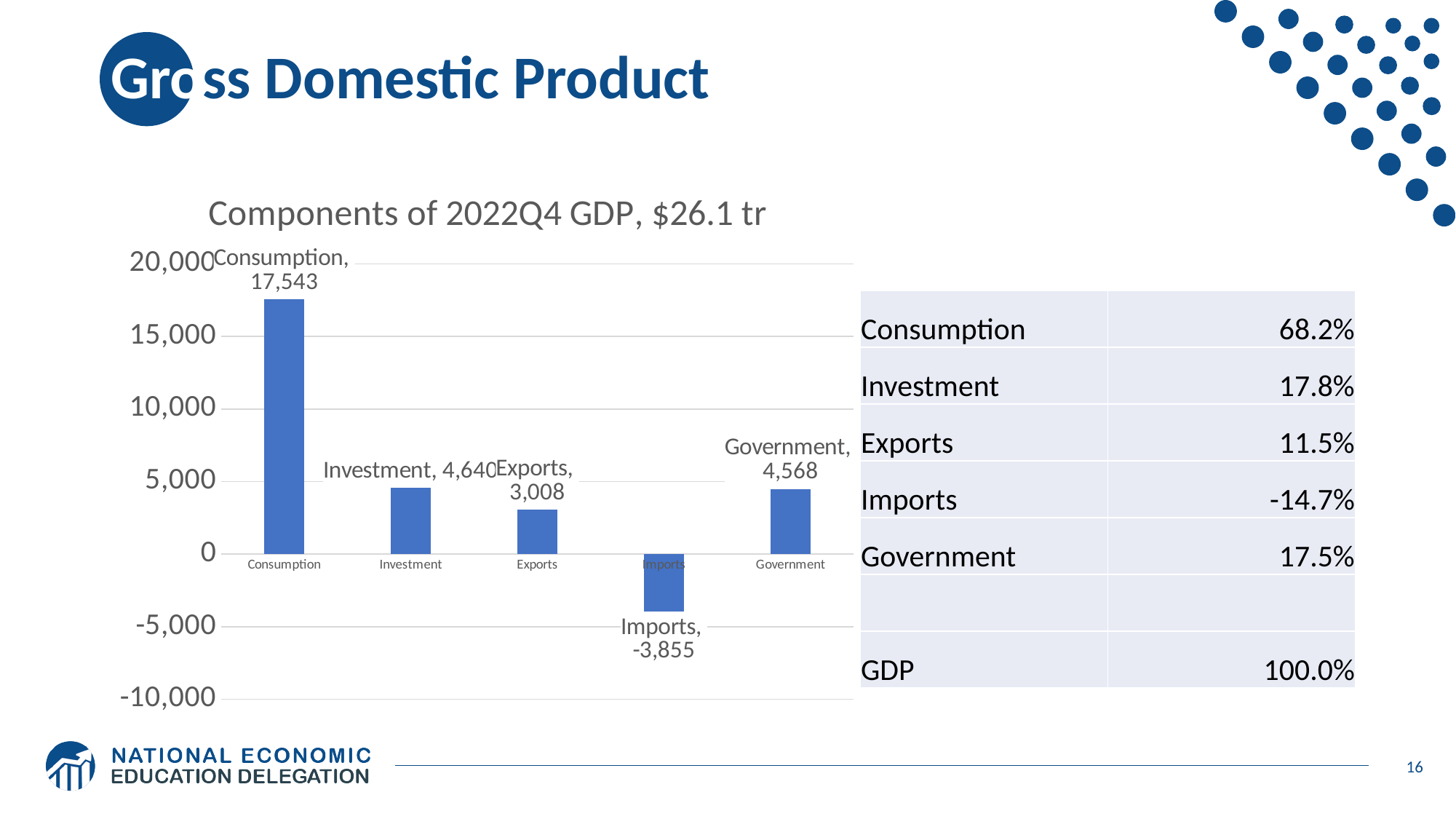
What is the title of the chart? Components of 2022Q4 GDP, $26.1 tr Is the value for Consumption greater or less than 15,000? greater What is the value for Investment in the chart? 4,640 Which component has the lowest value in the chart? Imports What is the value for Consumption in the Components of 2022Q4 GDP chart? 17,543 What is the value for Government in the chart? 4,568 What is the value for Imports in the chart? -3,855 Which is larger, the value for Exports or the value for Government? Government How many components are plotted in the chart? 5 What is the difference between the Investment and Government values? 72 What is the difference between the Consumption and Investment values? 12,903 Which component has the highest value in the chart? Consumption